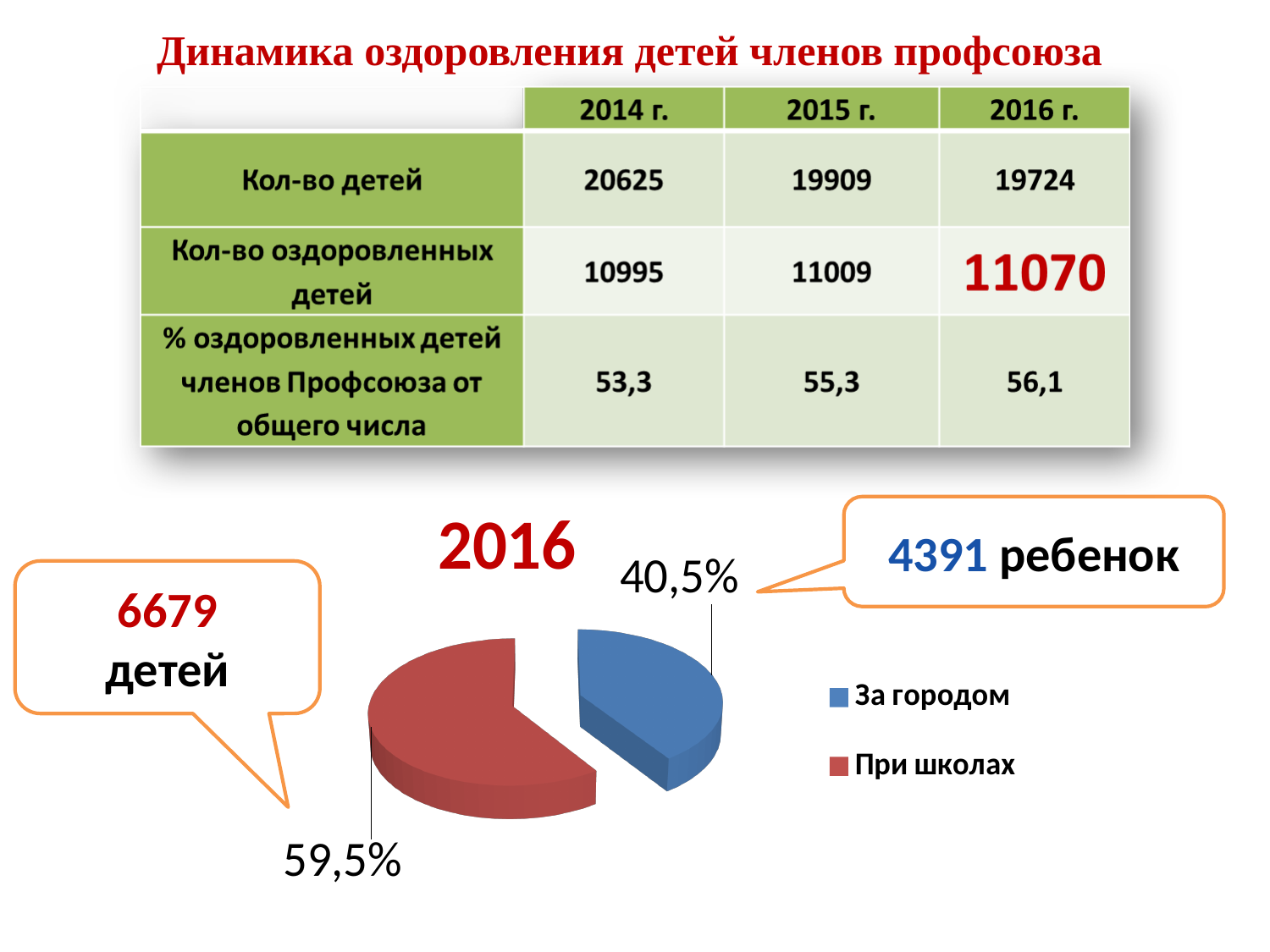
Is the share for За городом in the pie chart greater or less than 50%? less Which slice of the pie chart is the smallest? За городом What share of the pie chart is labelled "За городом"? 40,5% What colour is the За городом slice in the pie chart? blue What kind of chart is shown at the bottom of the slide? pie chart What is the title of the pie chart? 2016 How many entries does the legend of the pie chart list? 2 In the pie chart, which is larger: За городом or При школах? При школах What is the difference in percentage points between the При школах and За городом slices of the pie chart? 19 percentage points Which slice of the pie chart is the largest? При школах What share of the pie chart is labelled "При школах"? 59,5% How many slices does the pie chart have? 2